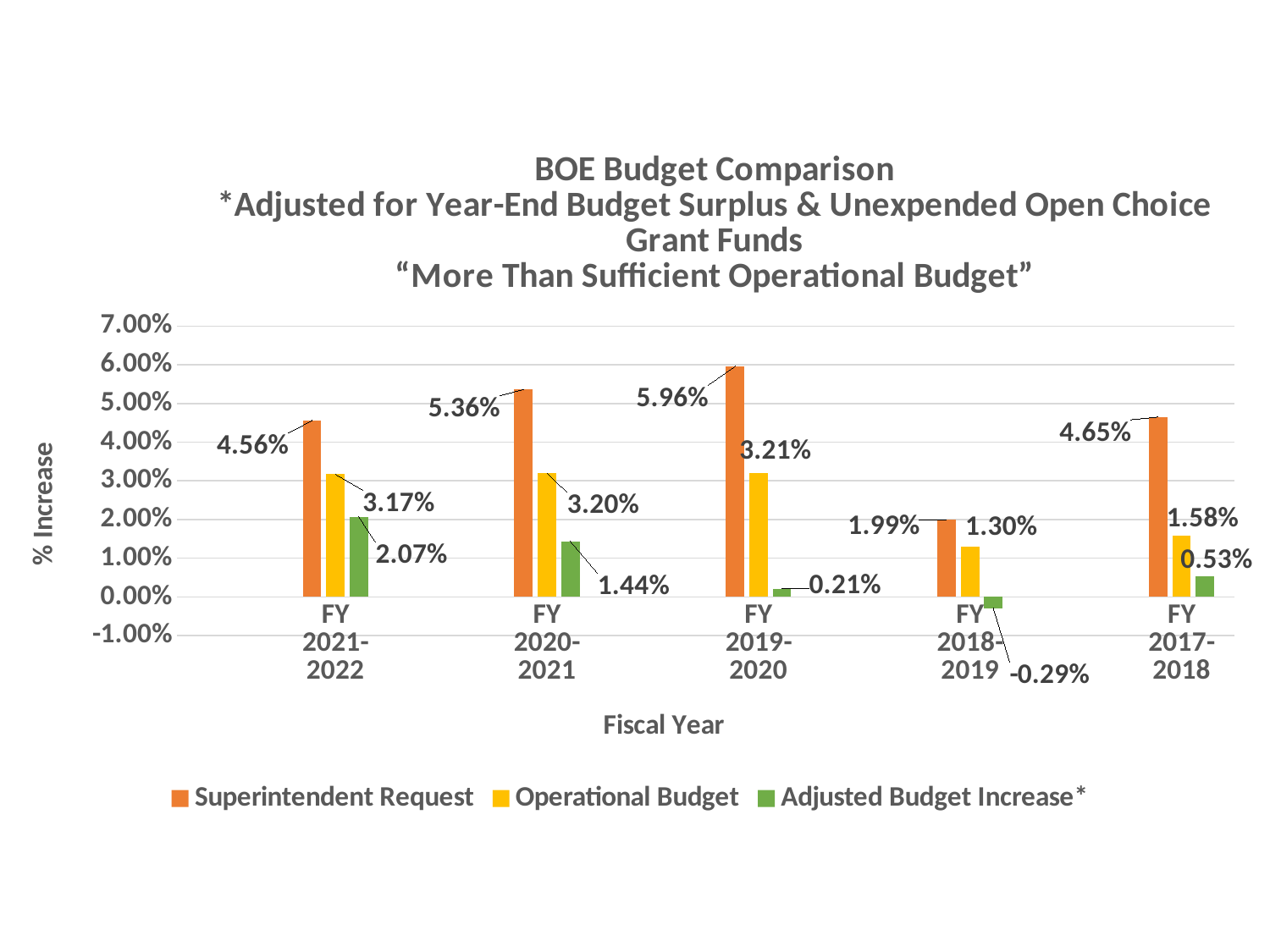
Which fiscal year has the lowest Adjusted Budget Increase* value? FY 2018-2019 What is the Superintendent Request value for FY 2019-2020? 5.96% Which fiscal year has the highest Superintendent Request value? FY 2019-2020 Which is larger for FY 2017-2018: the Superintendent Request or the Operational Budget? Superintendent Request How many fiscal years are shown on the x axis? 5 How many series does the legend list? 3 What is the Operational Budget value for FY 2021-2022? 3.17% What is the Operational Budget value for FY 2017-2018? 1.58% What is the difference between the Superintendent Request and the Operational Budget for FY 2020-2021? 2.16% What is the label of the y axis? % Increase What kind of chart is shown on the slide? Bar chart What is the Adjusted Budget Increase* value for FY 2018-2019? -0.29%